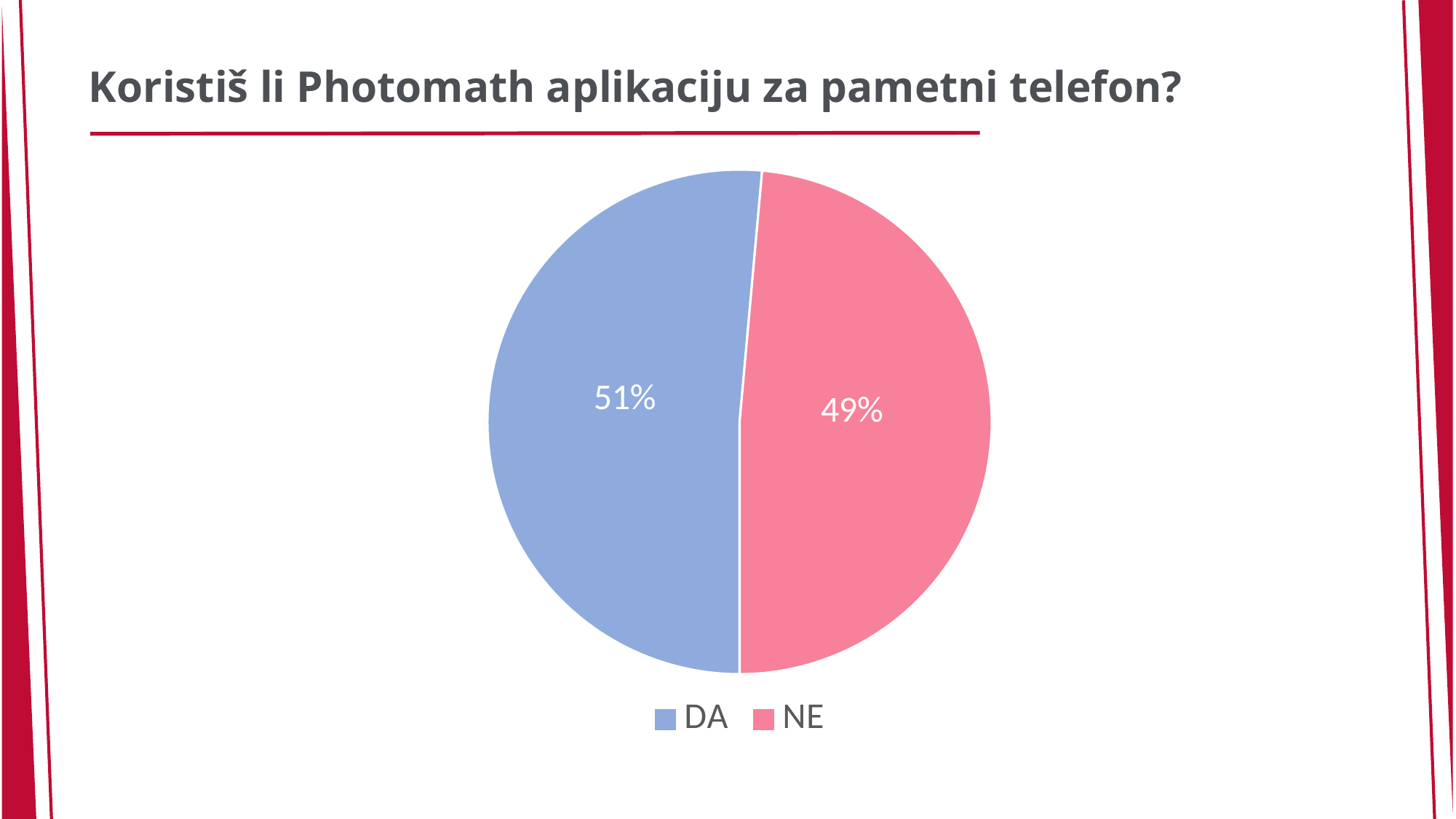
What percentage of the pie chart is labelled NE? 49% What is the difference in percentage points between the DA and NE slices? 2 What is the title of the slide above the chart? Koristiš li Photomath aplikaciju za pametni telefon? What share of the pie does the NE slice represent? 49% What percentage of the pie chart is labelled DA? 51% How many slices does the pie chart have? 2 Which slice of the pie chart is the smallest? NE What colour is the DA slice in the pie chart? blue Which slice of the pie chart is the largest? DA What kind of chart is shown on the slide? pie chart Which slice is larger, DA or NE? DA